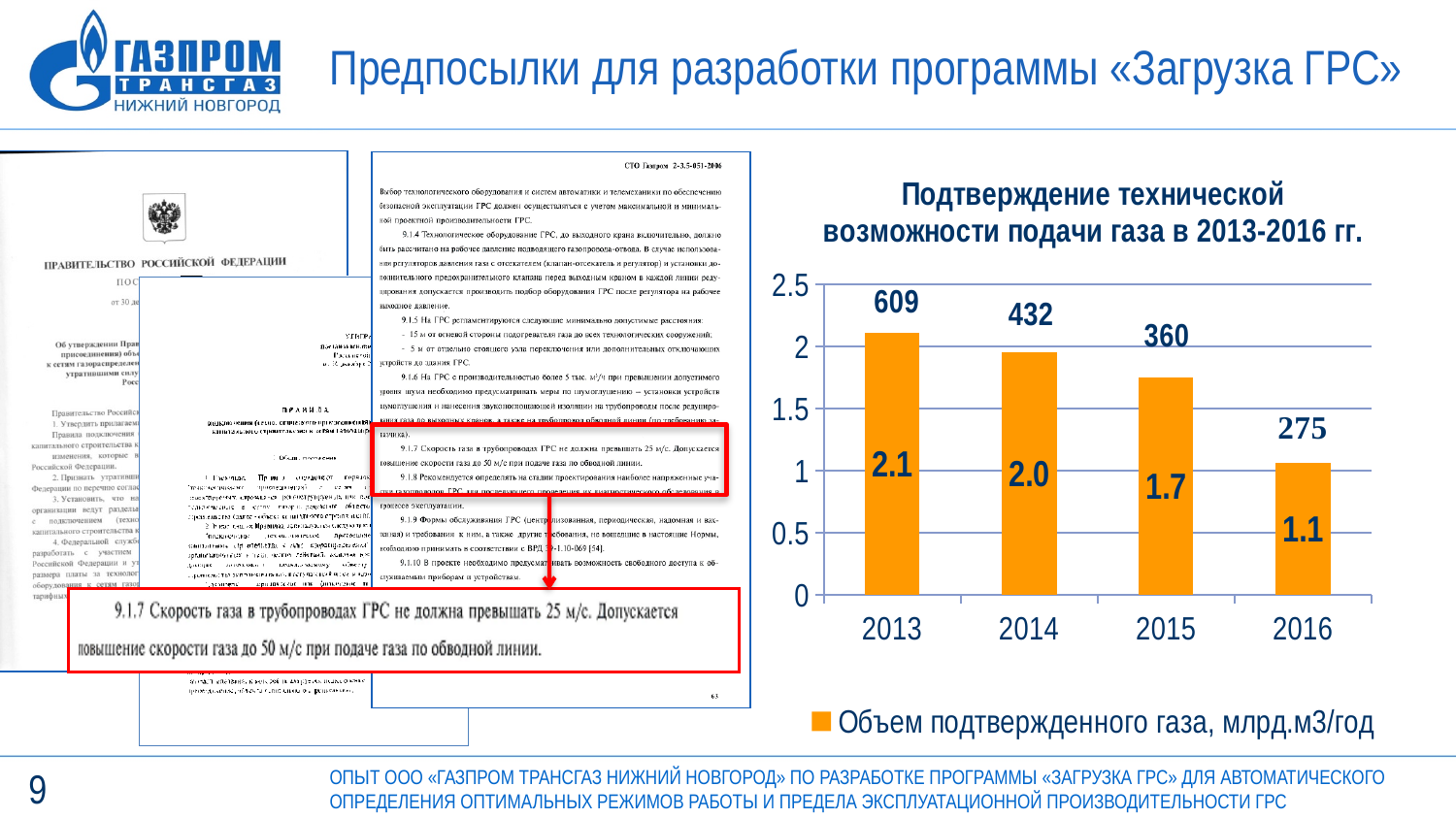
What is the difference in confirmed gas volume between 2013 and 2016? 1.0 Which year has the highest volume of confirmed gas? 2013 How many years are shown on the x axis of the chart? 4 What is the volume of confirmed gas (млрд.м3/год) for 2015? 1.7 What type of chart is shown on the slide? bar chart Which year has the lowest volume of confirmed gas? 2016 Do the bar values rise or fall from 2013 to 2016? fall Which year has a larger confirmed gas volume, 2014 or 2015? 2014 What is the volume of confirmed gas (млрд.м3/год) for 2013? 2.1 What number is printed above the bar for 2016? 275 What is the volume of confirmed gas (млрд.м3/год) for 2016? 1.1 What number is printed above the bar for 2014? 432